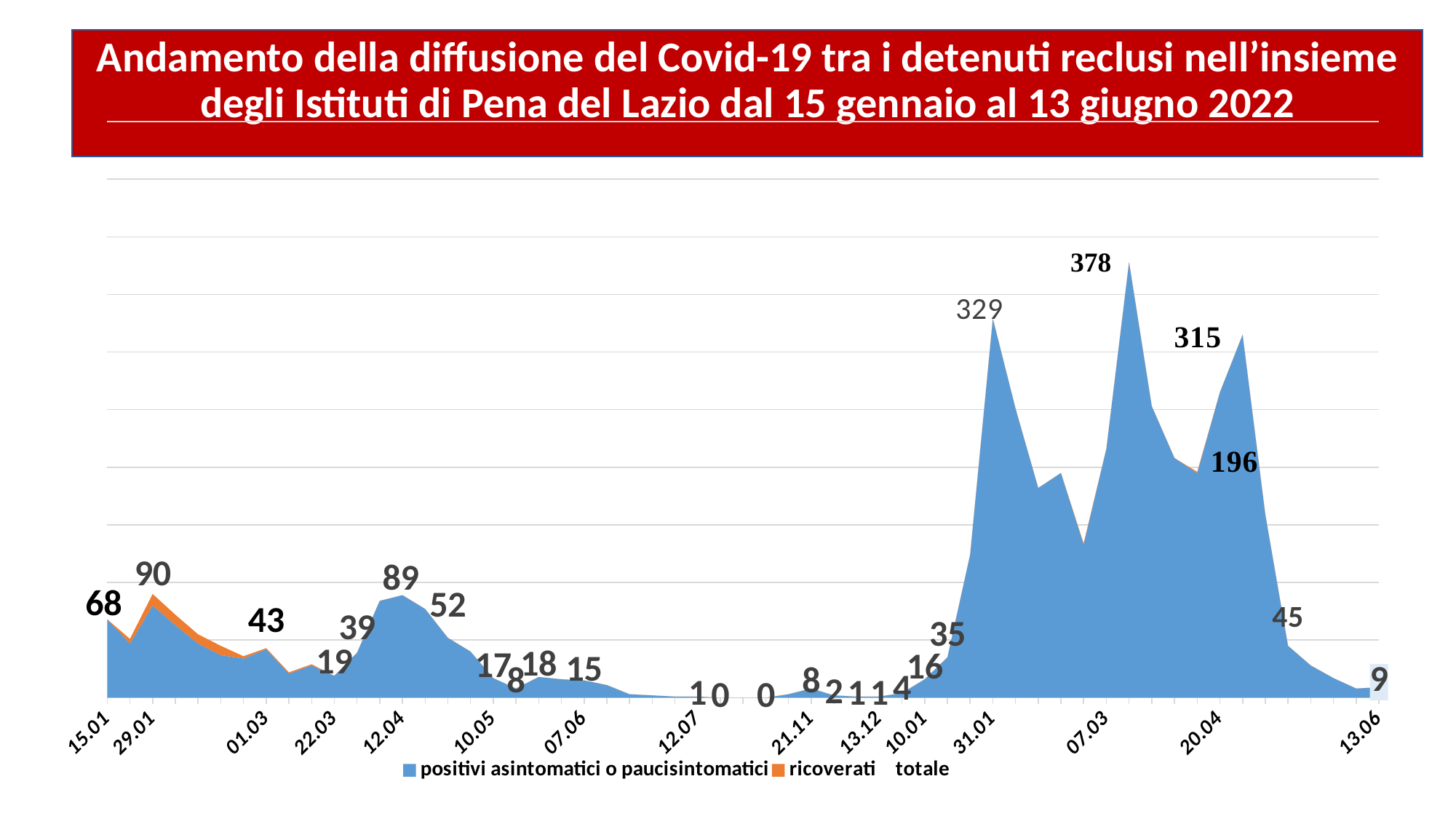
What is the lowest labelled value on the chart? 0 What is the highest labelled value on the chart? 378 What is the labelled value at the last date, 13.06? 9 What kind of chart is shown on the slide? area chart Do the values rise or fall between the peak labelled 315 and the final date 13.06? fall What colour is used for the 'ricoverati' series in the legend? orange What is the difference between the peak labelled 378 and the later peak labelled 315? 63 What is the labelled value at the first date, 15.01? 68 What is the name of the first series in the legend? positivi asintomatici o paucisintomatici Which is larger, the peak labelled 329 or the peak labelled 315? 329 How many series does the legend list? 3 What is the difference between the peak value 378 and the earlier peak labelled 329? 49